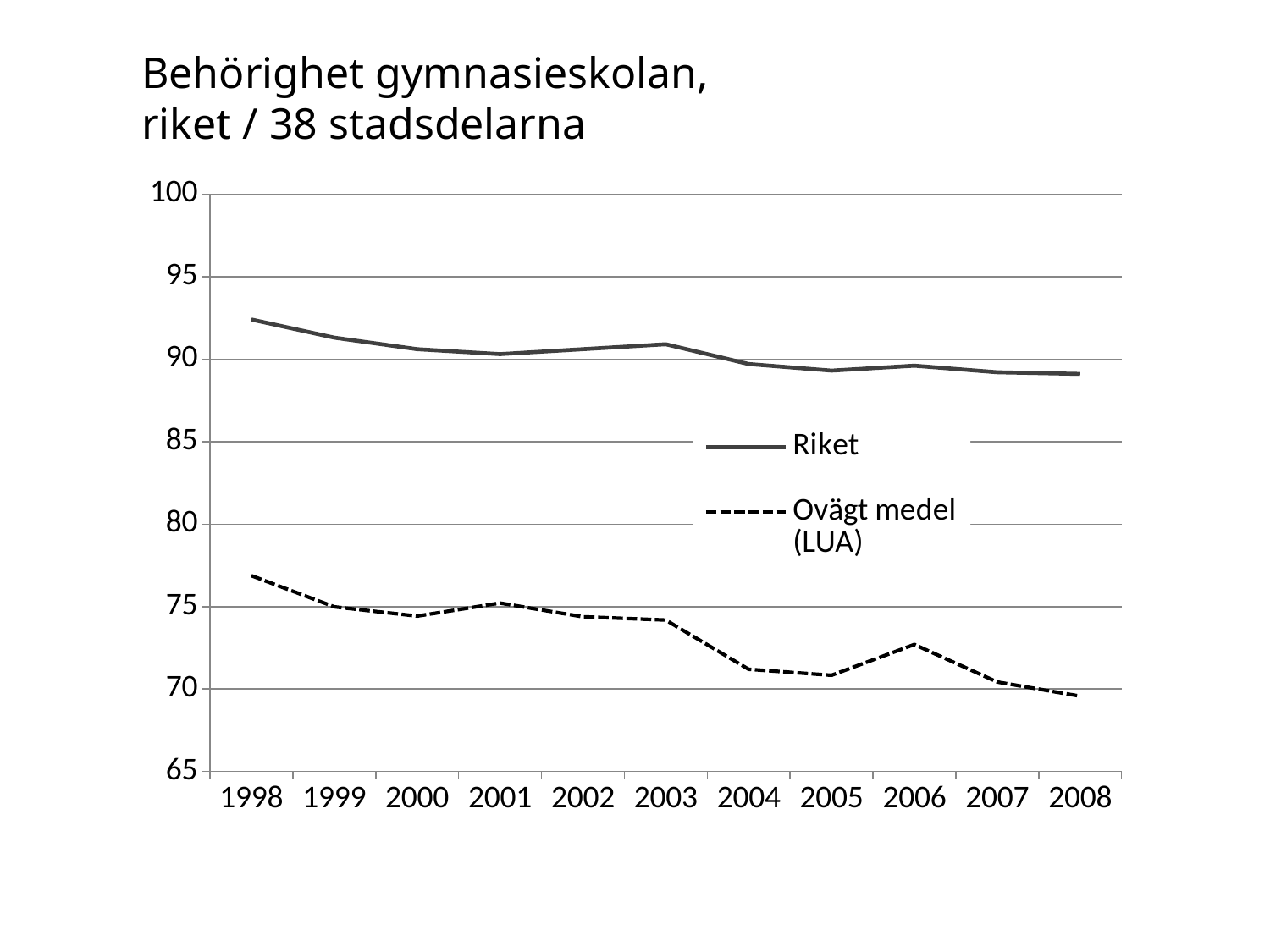
In which year is the Ovägt medel (LUA) series at its highest? 1998 Which series is drawn with a dashed line? Ovägt medel (LUA) In which year is the Ovägt medel (LUA) series at its lowest? 2008 Is the value for Ovägt medel (LUA) in 2008 greater or less than 70? less How many series does the legend list? 2 How many years are plotted along the x axis? 11 Is the value for Riket in 2008 greater or less than 90? less In which year is the Riket series at its highest? 1998 What is the title of the chart? Behörighet gymnasieskolan, riket / 38 stadsdelarna Which series has the larger value in 2003, Riket or Ovägt medel (LUA)? Riket What kind of chart is shown on the slide? line chart Do the values for Ovägt medel (LUA) generally rise or fall from 1998 to 2008? fall